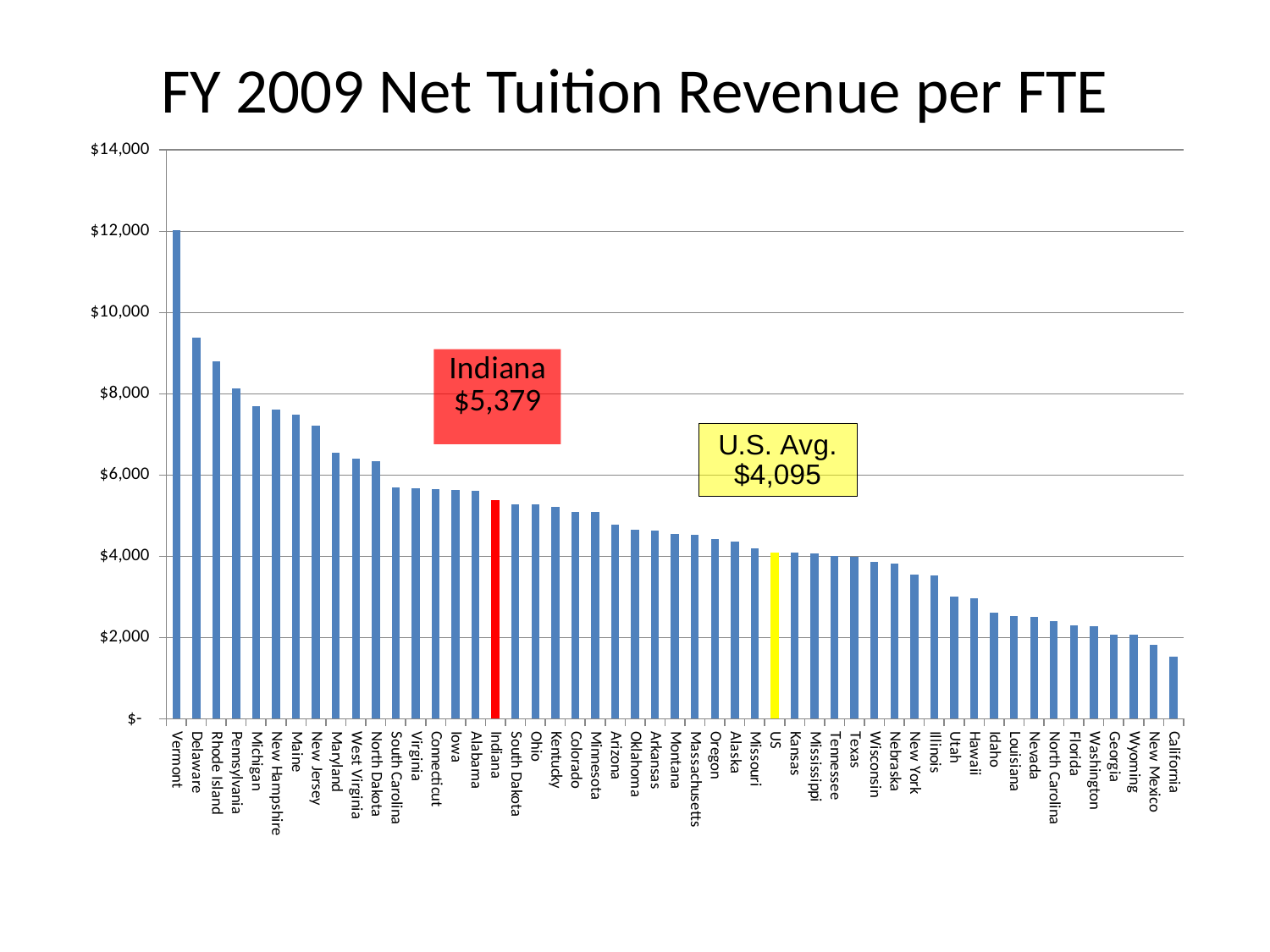
What is the U.S. average net tuition revenue per FTE shown on the chart? $4,095 How much higher is Indiana's value than the U.S. average? $1,284 Is the value for Vermont greater or less than $10,000? greater Which state has the lowest net tuition revenue per FTE? California Is the value for California greater or less than $2,000? less Do the values rise or fall moving from left to right along the x axis? fall What is the title of the chart? FY 2009 Net Tuition Revenue per FTE Which is larger, the value for Vermont or the value for Delaware? Vermont What colour is the bar for Indiana? red What kind of chart is shown on the slide? bar chart Which state has the highest net tuition revenue per FTE? Vermont What is the net tuition revenue per FTE for Indiana? $5,379